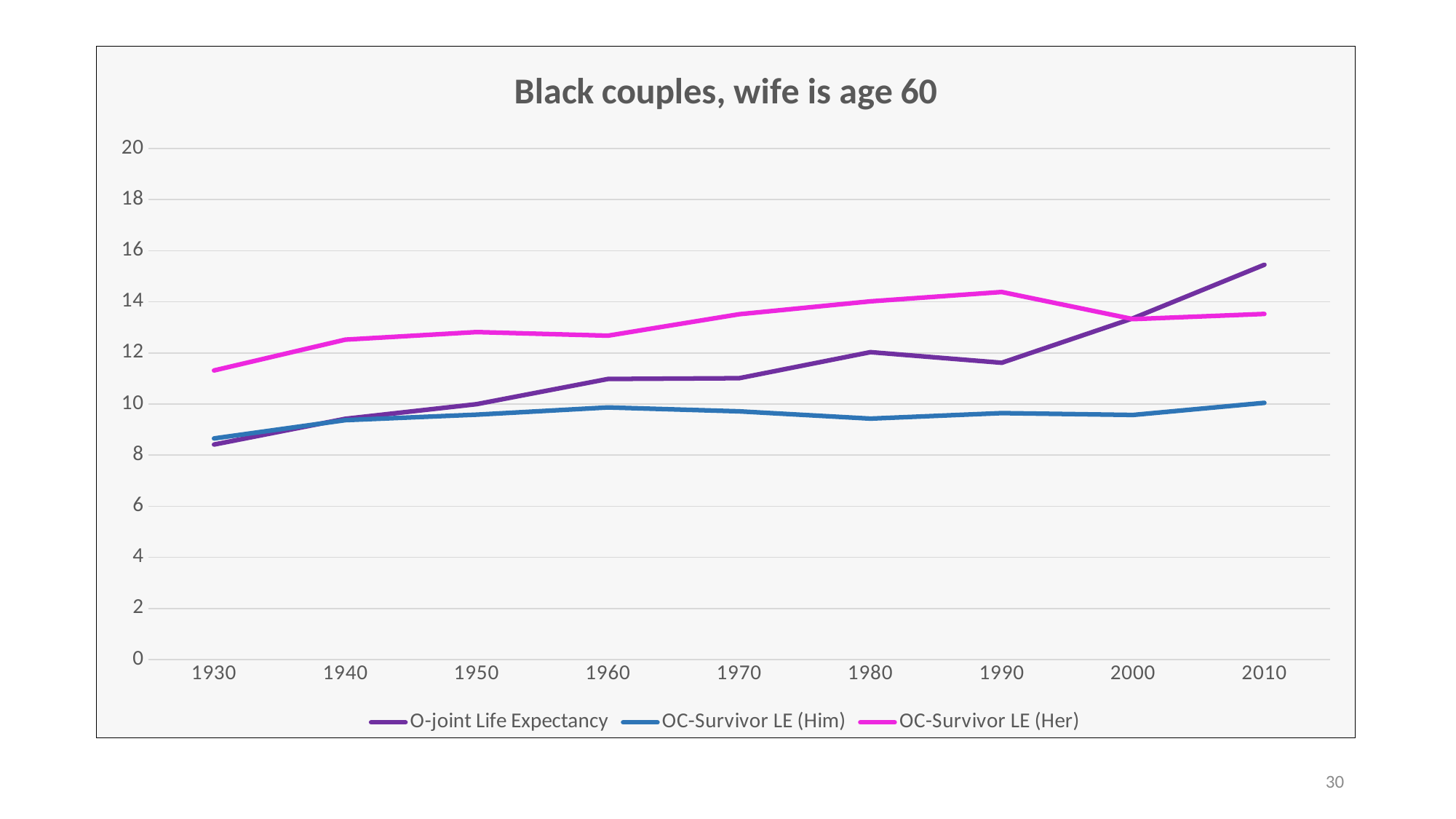
In which year is O-joint Life Expectancy at its highest? 2010 What kind of chart is shown on the slide? line chart Which series has the highest value in 1980? OC-Survivor LE (Her) In 1990, which is larger: OC-Survivor LE (Her) or O-joint Life Expectancy? OC-Survivor LE (Her) In 2010, which is larger: O-joint Life Expectancy or OC-Survivor LE (Her)? O-joint Life Expectancy How many years are plotted along the x axis? 9 How many series does the legend list? 3 Which series has the lowest value in 2010? OC-Survivor LE (Him) Is the value for OC-Survivor LE (Him) in 1930 greater or less than 10? less What is the title of the chart? Black couples, wife is age 60 Is the value for OC-Survivor LE (Her) in 1930 greater or less than 10? greater Is the value for O-joint Life Expectancy in 2010 greater or less than 14? greater